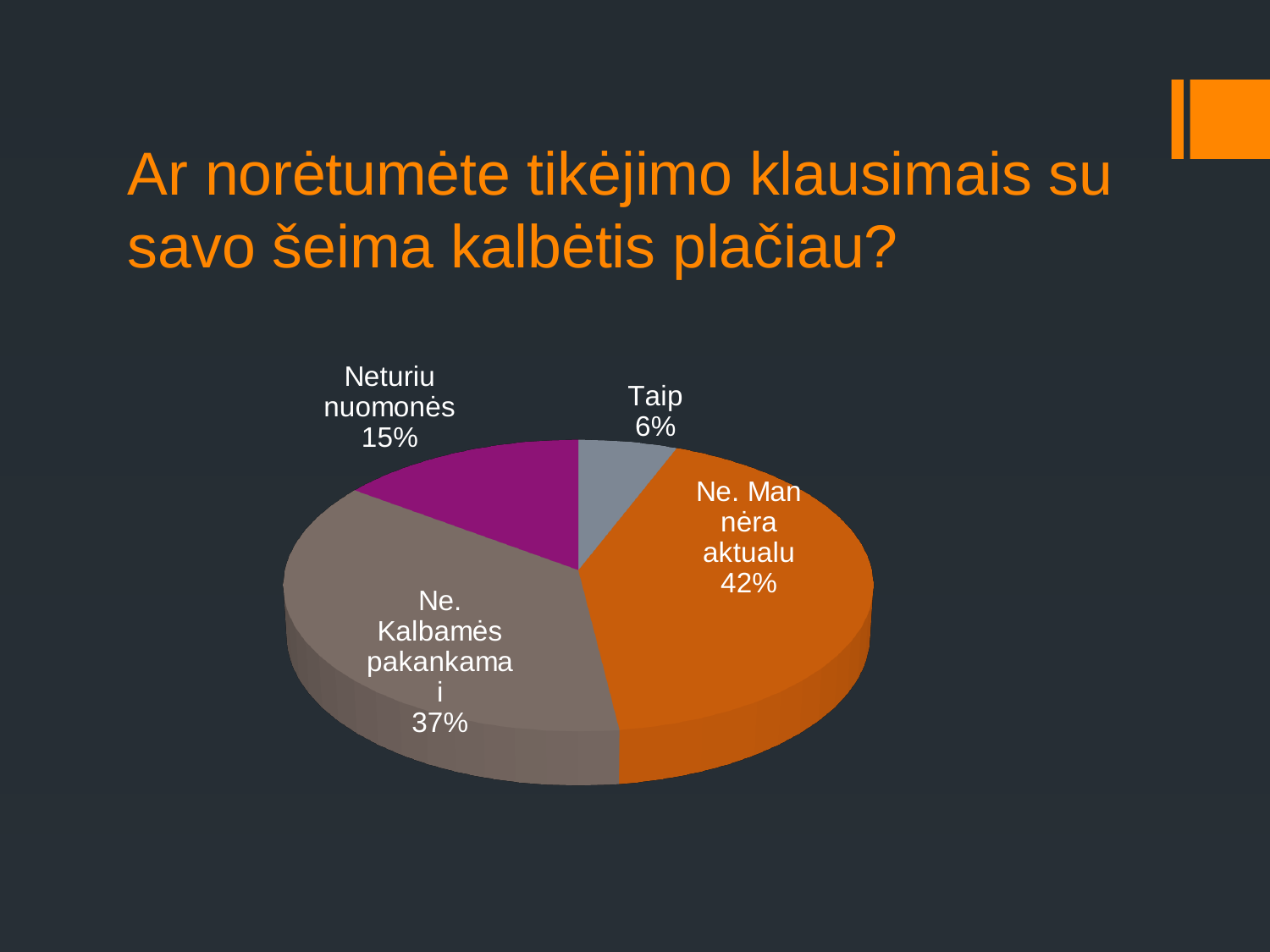
What is the title of the slide above the chart? Ar norėtumėte tikėjimo klausimais su savo šeima kalbėtis plačiau? What kind of chart is shown on the slide? Pie chart What share of the pie does "Taip" represent? 6% What is the difference in percentage points between "Ne. Man nėra aktualu" and "Ne. Kalbamės pakankamai"? 5 percentage points How many categories are shown in the pie chart? 4 Which is larger: the share for "Neturiu nuomonės" or the share for "Taip"? Neturiu nuomonės What is the difference in percentage points between "Neturiu nuomonės" and "Taip"? 9 percentage points Which category has the largest slice of the pie? Ne. Man nėra aktualu What share of the pie does "Ne. Man nėra aktualu" represent? 42% What share of the pie does "Ne. Kalbamės pakankamai" represent? 37% Which category has the smallest slice of the pie? Taip What share of the pie does "Neturiu nuomonės" represent? 15%